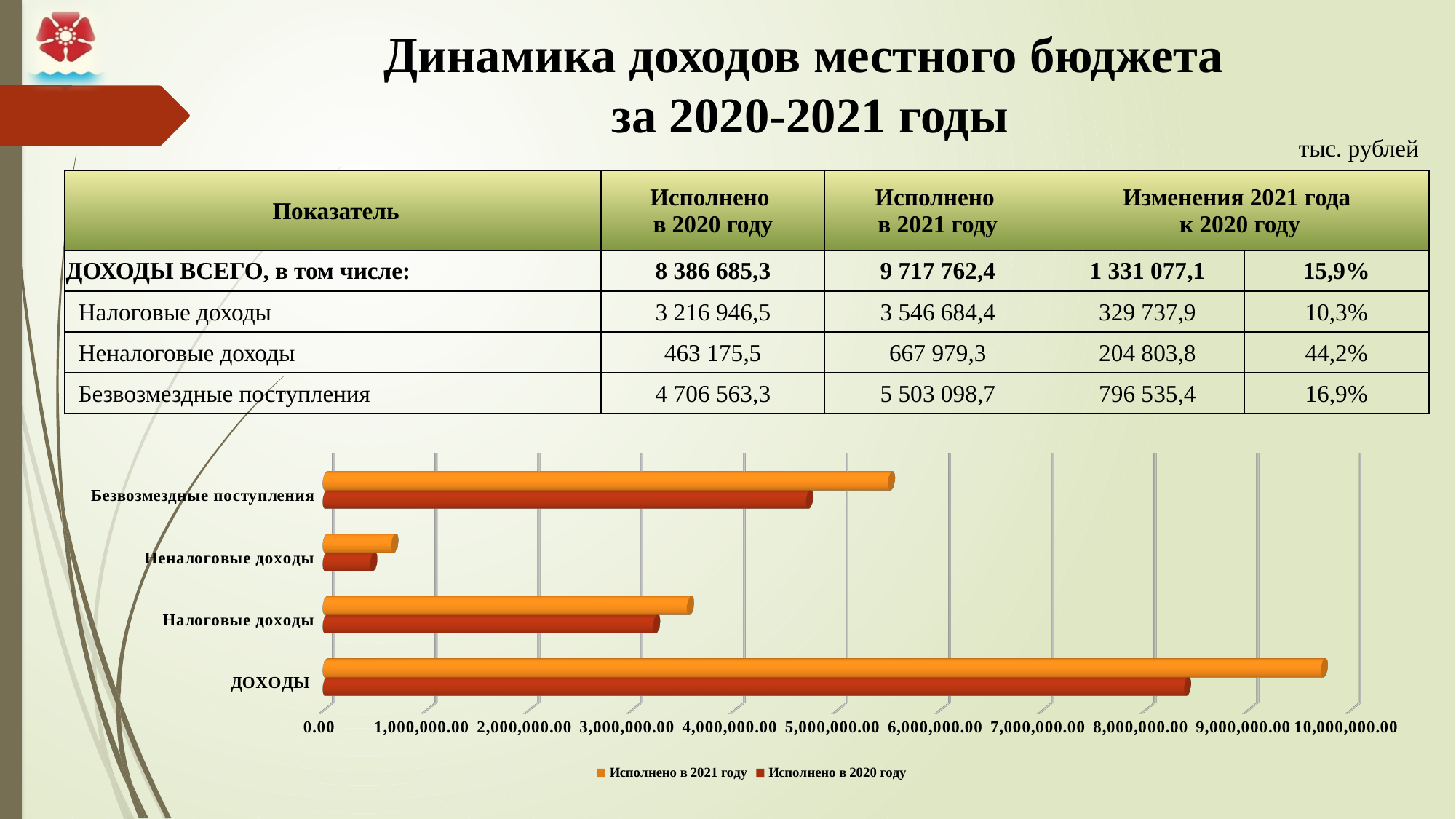
Is the "Исполнено в 2021 году" bar for Неналоговые доходы greater or less than 1,000,000.00? less For Налоговые доходы, which bar is longer: "Исполнено в 2021 году" or "Исполнено в 2020 году"? Исполнено в 2021 году Is the "Исполнено в 2020 году" bar for ДОХОДЫ greater or less than 8,000,000.00? greater How many categories are shown on the chart's vertical axis? 4 Is the "Исполнено в 2021 году" bar for ДОХОДЫ greater or less than 9,000,000.00? greater Which category has the shortest bar for "Исполнено в 2020 году"? Неналоговые доходы Which legend entry is shown in orange on the chart? Исполнено в 2021 году For "Исполнено в 2021 году", which bar is longer: Безвозмездные поступления or Налоговые доходы? Безвозмездные поступления How many series does the chart legend list? 2 Which category has the longest bar for "Исполнено в 2021 году"? ДОХОДЫ What kind of chart is shown on the slide? bar chart